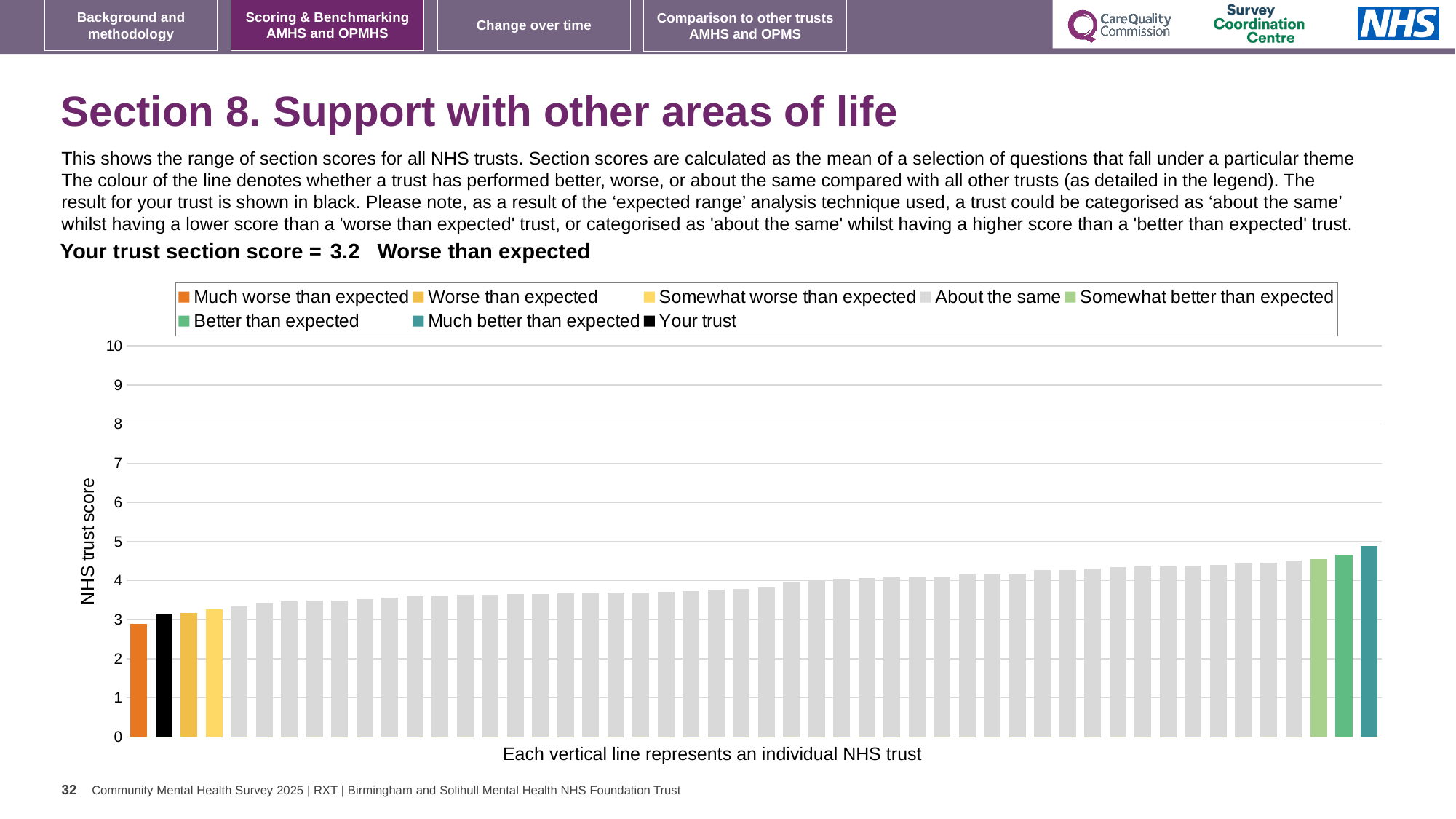
How many entries does the chart legend list? 8 How is your trust's section score categorised compared with other trusts? Worse than expected Which legend category does the highest bar in the chart belong to? Much better than expected What colour is used for the bar representing your trust? black Is the value of the tallest bar (Much better than expected) greater or less than 4? greater Is the value for your trust (the black bar) greater or less than 5? less Is the value of the shortest bar (Much worse than expected) greater or less than 4? less What is the section score for your trust shown on the slide? 3.2 What kind of chart is shown on the slide? bar chart Which legend category does the lowest bar in the chart belong to? Much worse than expected What is the label on the vertical axis of the chart? NHS trust score Do the bar values rise or fall from left to right along the x axis? rise